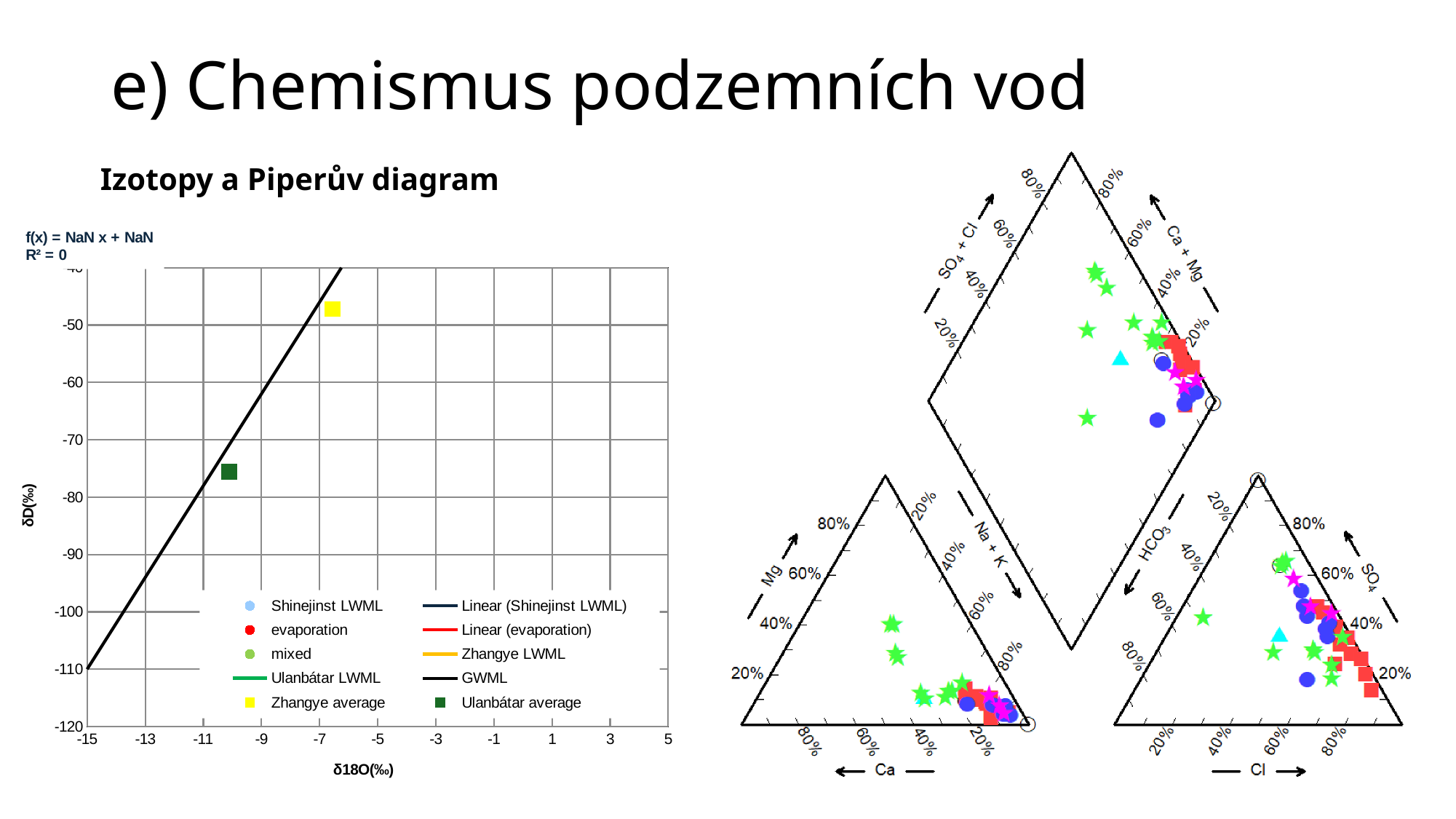
On the left-hand chart, is the δD value for Zhangye average greater or less than -50? greater On the left-hand chart, what is the lowest value shown on the x axis? -15 What is the label of the x axis on the left-hand chart? δ18O(‰) On the left-hand chart, what is the lowest value shown on the y axis? -120 On the left-hand chart, how many entries does the legend list? 10 On the left-hand chart, is the δ18O value for Ulanbátar average greater or less than -9? less On the left-hand chart, what colour is the marker for Zhangye average in the legend? yellow On the left-hand chart, is the δ18O value for Zhangye average greater or less than -9? greater On the left-hand chart, which plotted point has the higher δD value, Zhangye average or Ulanbátar average? Zhangye average On the left-hand chart, how many data points (squares) are plotted? 2 What kind of chart is the left-hand chart on the slide? scatter chart